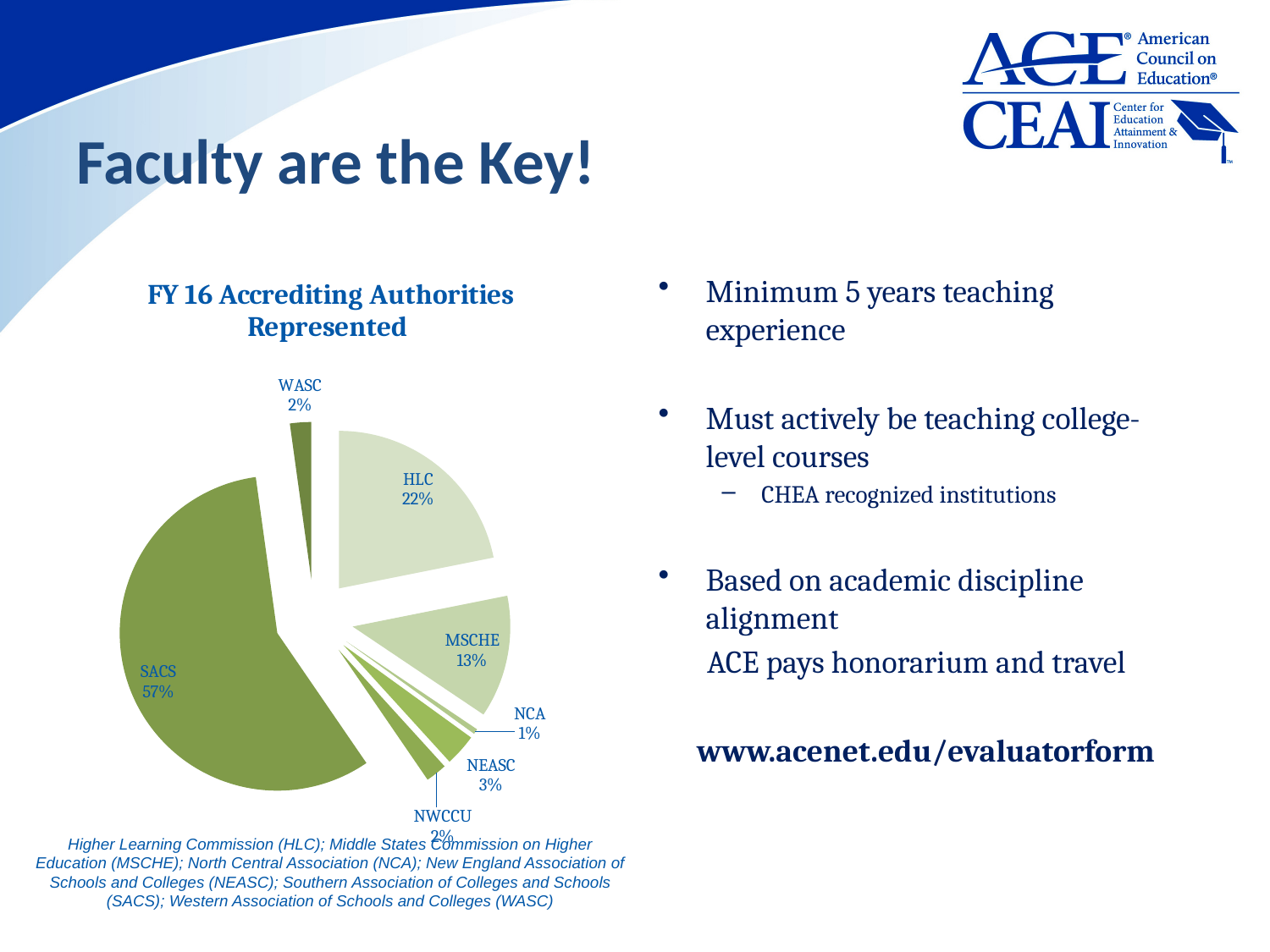
What is the difference in percentage points between SACS and HLC? 35 percentage points What type of chart is shown on the slide? Pie chart What is the title of the chart on the slide? FY 16 Accrediting Authorities Represented What share of the pie does SACS represent? 57% What percentage is shown for WASC? 2% How many slices does the pie chart have? 7 Which accrediting authority has the largest slice of the pie? SACS Which accrediting authority has the smallest slice of the pie? NCA What percentage is shown for MSCHE? 13% Which is larger, the share for HLC or the share for MSCHE? HLC What percentage is shown for HLC? 22% What percentage is shown for NEASC? 3%